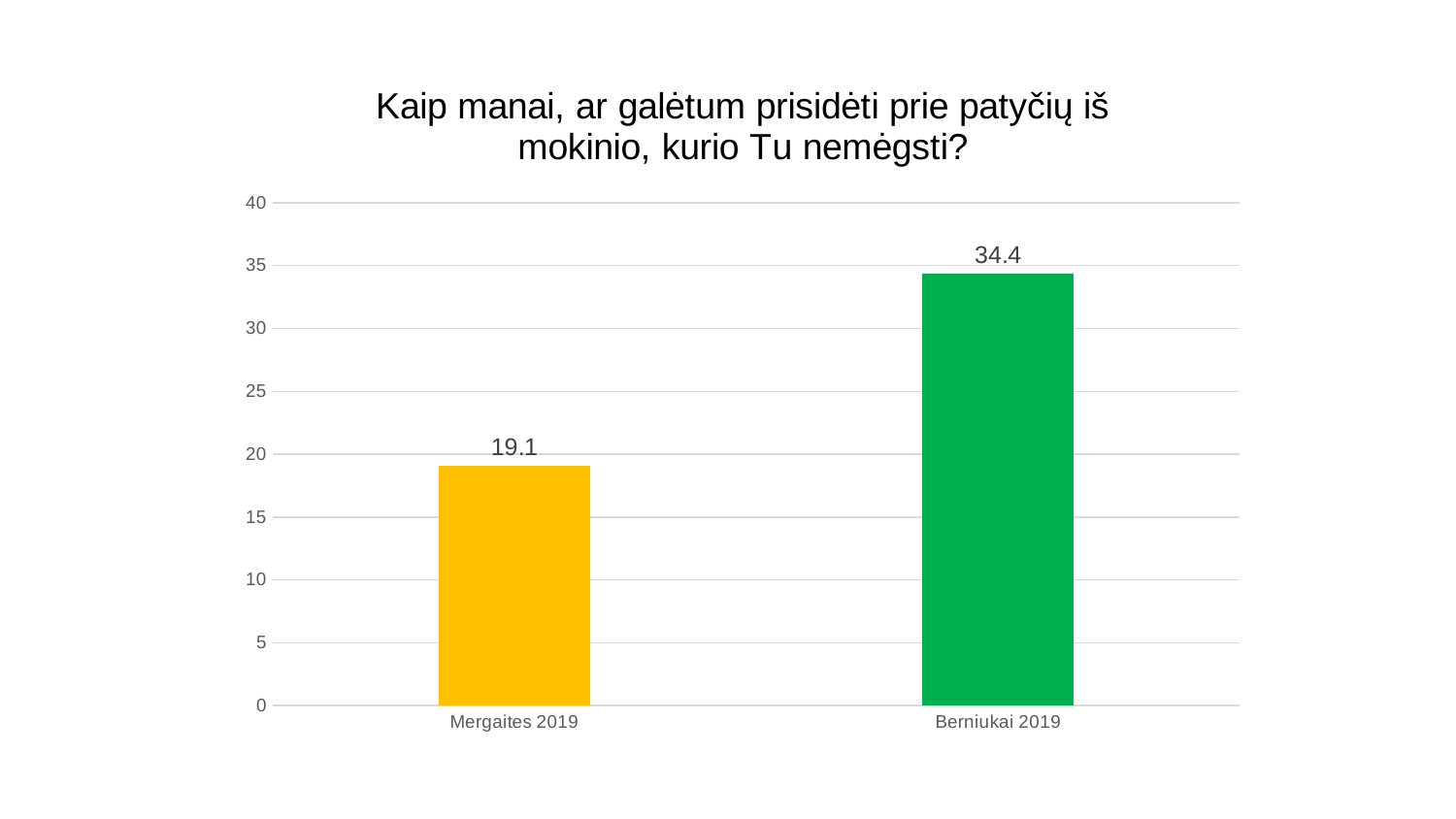
What is the value for Berniukai 2019? 34.4 What kind of chart is shown on the slide? bar chart How many categories are shown on the x axis? 2 What colour is the bar for Berniukai 2019? green What is the difference between the values for Berniukai 2019 and Mergaites 2019? 15.3 Is the value for Berniukai 2019 greater or less than 30? greater What is the value for Mergaites 2019? 19.1 What is the title of the chart? Kaip manai, ar galėtum prisidėti prie patyčių iš mokinio, kurio Tu nemėgsti? Which category has the lowest value? Mergaites 2019 Which is larger, the value for Mergaites 2019 or the value for Berniukai 2019? Berniukai 2019 Which category has the highest value? Berniukai 2019 Is the value for Mergaites 2019 greater or less than 20? less